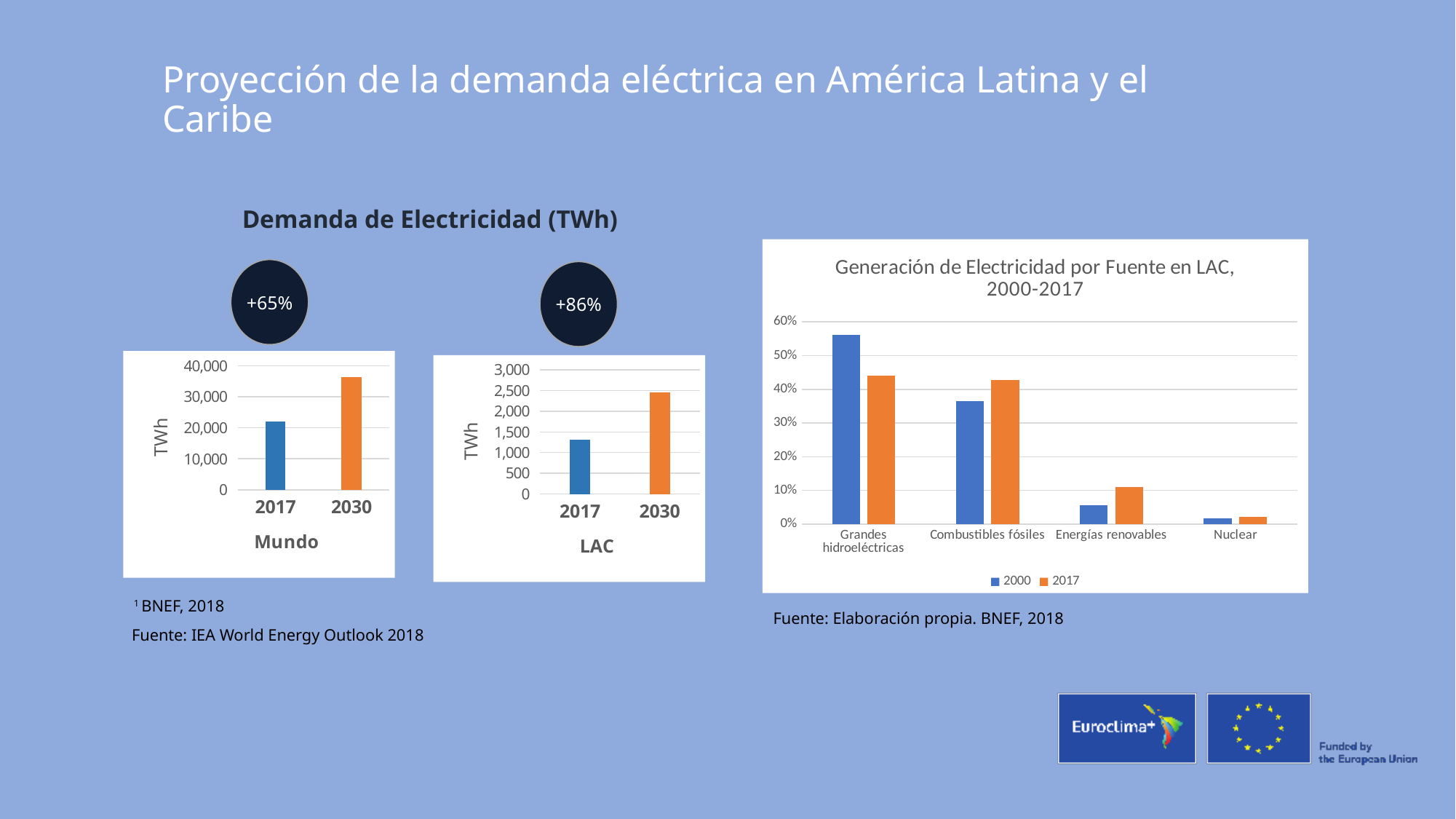
In the chart 'Generación de Electricidad por Fuente en LAC, 2000-2017', how many energy source categories are shown on the x axis? 4 In the chart 'Generación de Electricidad por Fuente en LAC, 2000-2017', is the 2017 value for Combustibles fósiles greater or less than 40%? greater What percentage increase is shown in the circle above the 'LAC' chart? +86% In the 'Mundo' chart, is the value for 2030 greater or less than 40,000? less In the 'Mundo' chart, which year has the higher electricity demand, 2017 or 2030? 2030 In the 'LAC' chart, is the value for 2030 greater or less than 2,000? greater In the chart 'Generación de Electricidad por Fuente en LAC, 2000-2017', how many series does the legend list? 2 In the chart 'Generación de Electricidad por Fuente en LAC, 2000-2017', which source had the lowest share in 2017? Nuclear In the chart 'Generación de Electricidad por Fuente en LAC, 2000-2017', which source had the highest share in 2000? Grandes hidroeléctricas What kind of chart is the 'Mundo' chart on the left? bar chart